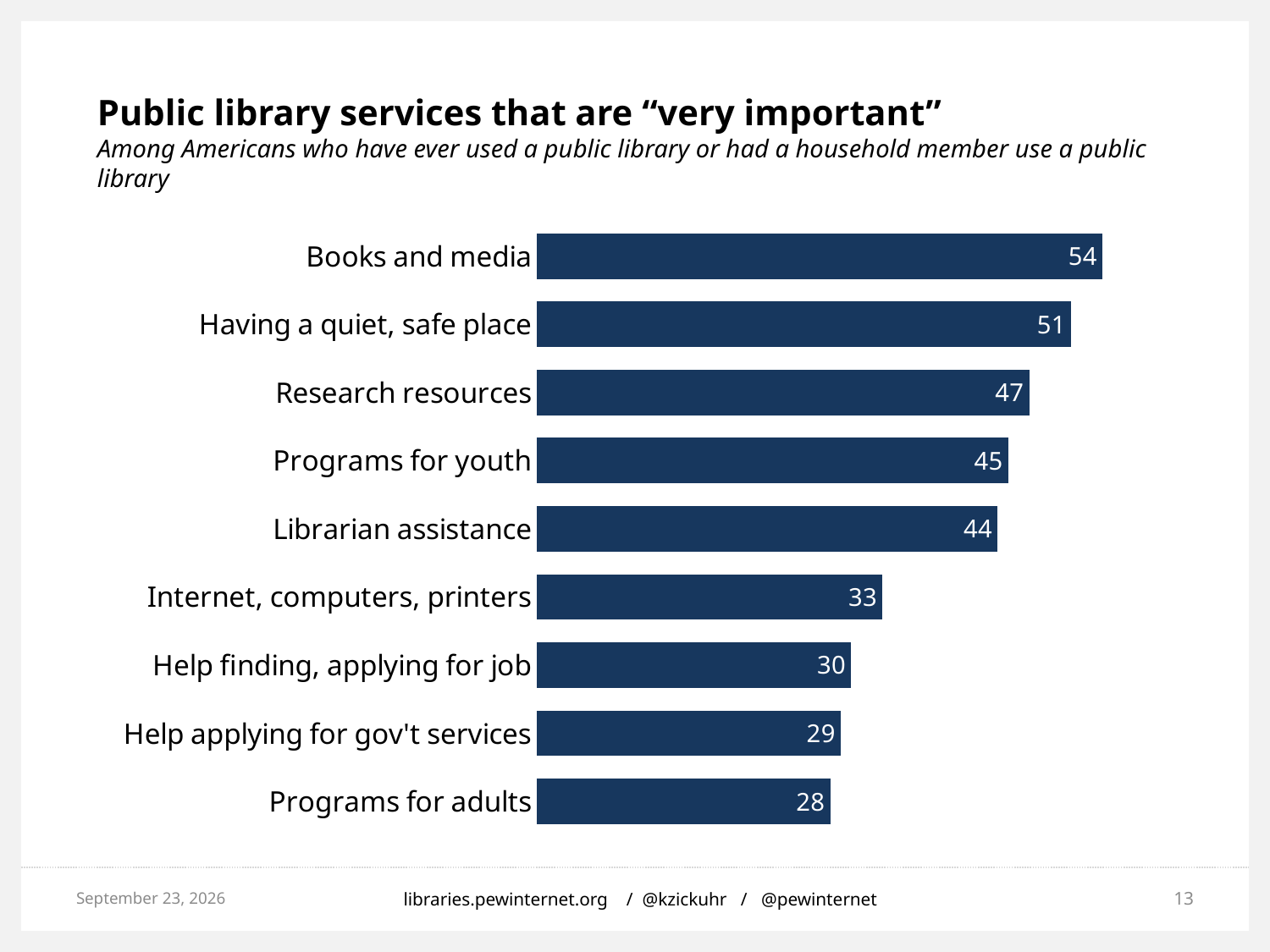
What is the difference between the values for Research resources and Internet, computers, printers? 14 Which category has the lowest value? Programs for adults What is the value for Help applying for gov't services? 29 How many categories are shown in the chart? 9 Which category has the highest value? Books and media What is the value for Librarian assistance? 44 What kind of chart is shown on the slide? Bar chart What is the difference between the values for Books and media and Programs for adults? 26 Which is larger, the value for Programs for youth or the value for Help finding, applying for job? Programs for youth What is the value for Books and media? 54 What is the title of the chart? Public library services that are “very important” What is the value for Having a quiet, safe place? 51